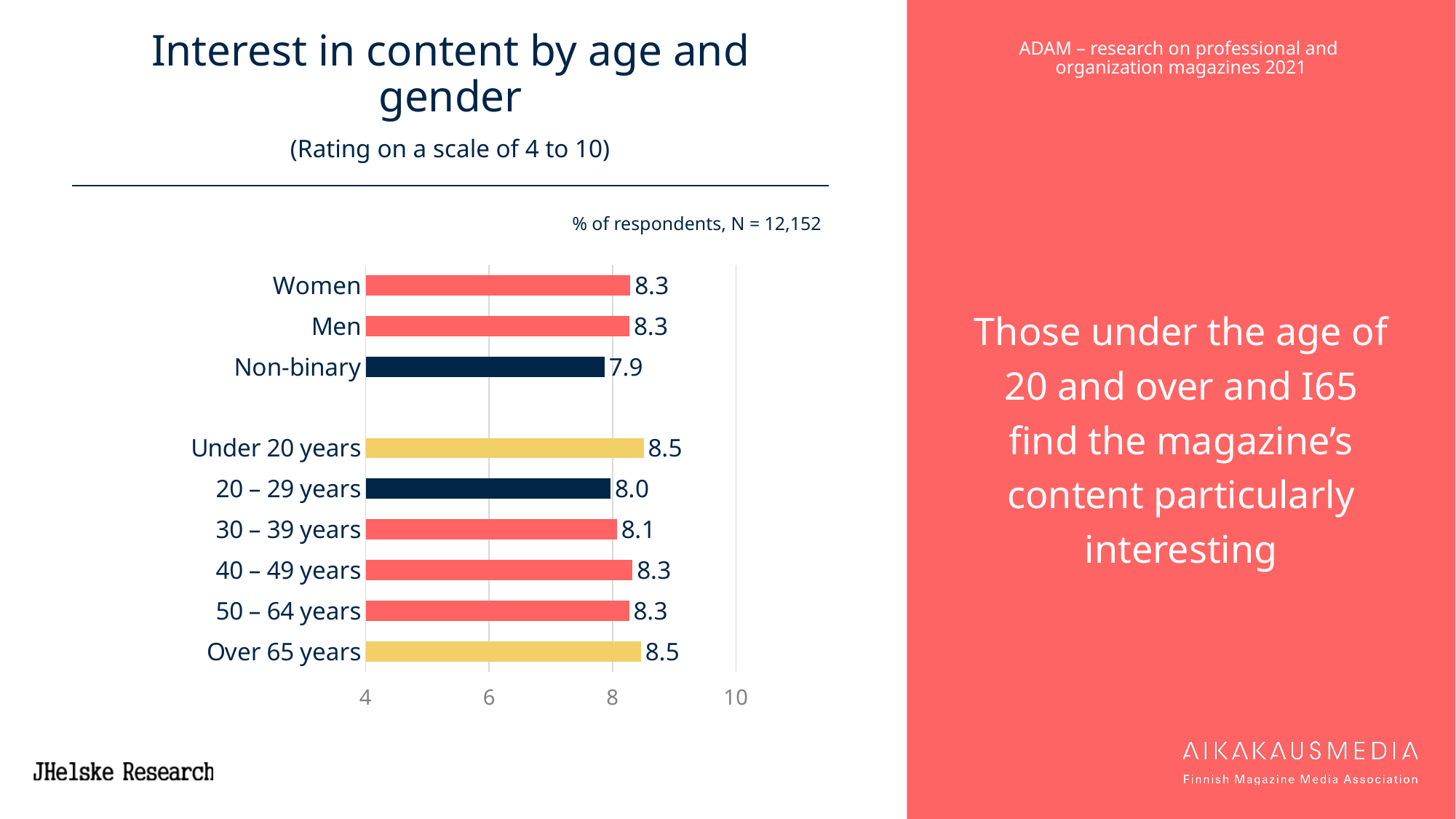
Which is higher, the rating for 30 – 39 years or the rating for Over 65 years? Over 65 years What is the difference between the rating for Women and the rating for Non-binary? 0.4 What is the rating for the Over 65 years age group? 8.5 How many categories are plotted in the chart? 9 What is the rating for Non-binary respondents? 7.9 Which age group has the lowest rating? 20 – 29 years What is the title of the chart? Interest in content by age and gender What is the rating for the 20 – 29 years age group? 8.0 What is the difference between the rating for Under 20 years and the rating for 20 – 29 years? 0.5 What is the rating for Women? 8.3 What kind of chart is shown on the slide? Bar chart Which category has the lowest rating? Non-binary